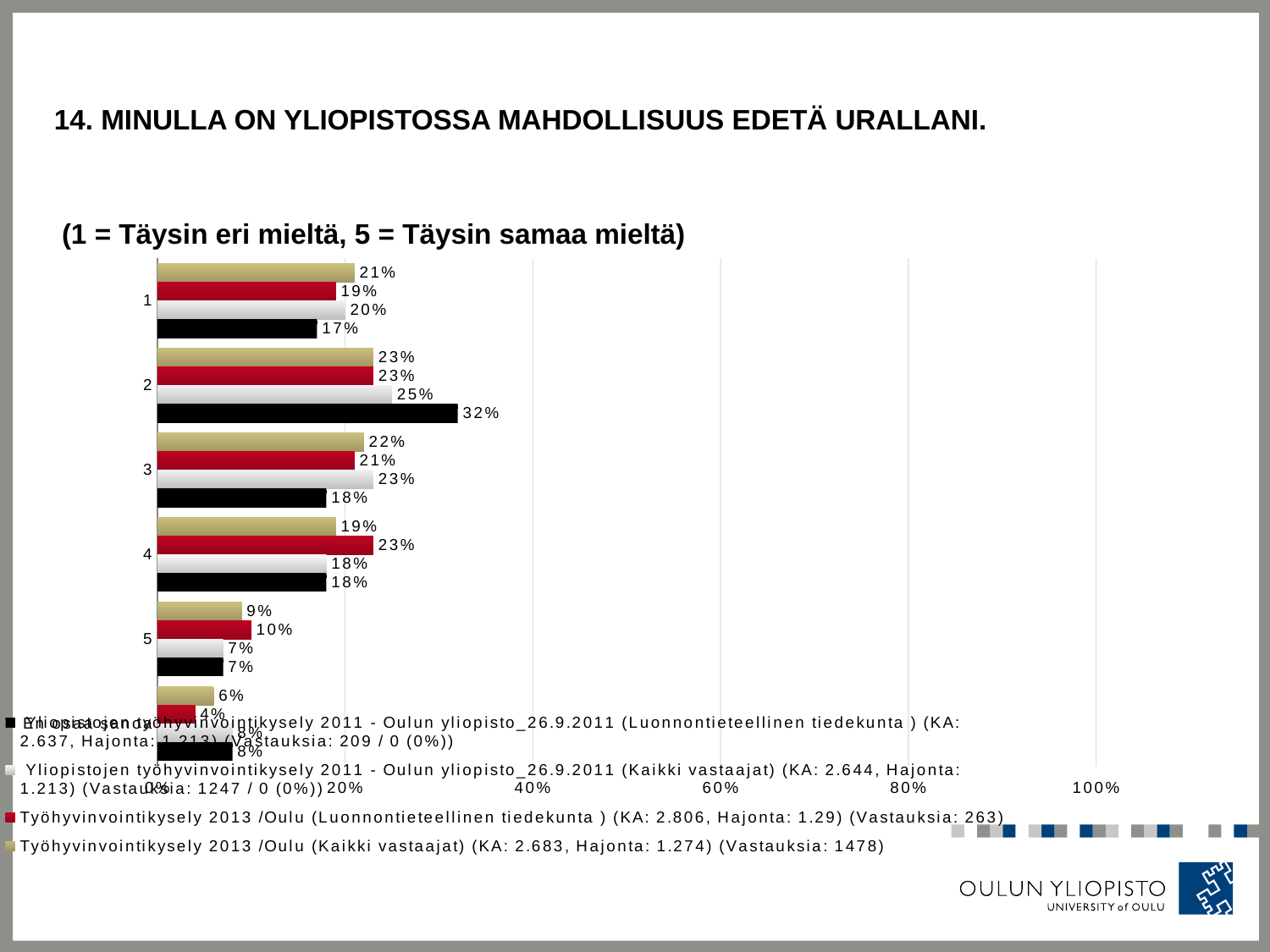
For which category (1–5) is the black bar (2011, Luonnontieteellinen tiedekunta) highest? 2 For category 3, which is larger: the grey bar (2011, Kaikki vastaajat) or the black bar (2011, Luonnontieteellinen tiedekunta)? grey bar (2011, Kaikki vastaajat) What is the title of the chart on the slide? 14. MINULLA ON YLIOPISTOSSA MAHDOLLISUUS EDETÄ URALLANI. Is the value of the black bar for category 2 greater or less than 20%? greater What type of chart is shown on the slide? bar chart What is the difference between the black bar and the grey bar for category 2? 7% For which category (1–5) is the red bar (2013, Luonnontieteellinen tiedekunta) lowest? 5 How many series does the legend list? 4 What is the value of the tan bar (Työhyvinvointikysely 2013 /Oulu, Kaikki vastaajat) for category 1? 21% What is the value of the red bar (Työhyvinvointikysely 2013 /Oulu, Luonnontieteellinen tiedekunta) for category 4? 23% What is the value of the black bar (Yliopistojen työhyvinvointikysely 2011, Luonnontieteellinen tiedekunta) for category 2? 32% What is the value of the grey bar (Yliopistojen työhyvinvointikysely 2011, Kaikki vastaajat) for category 5? 7%